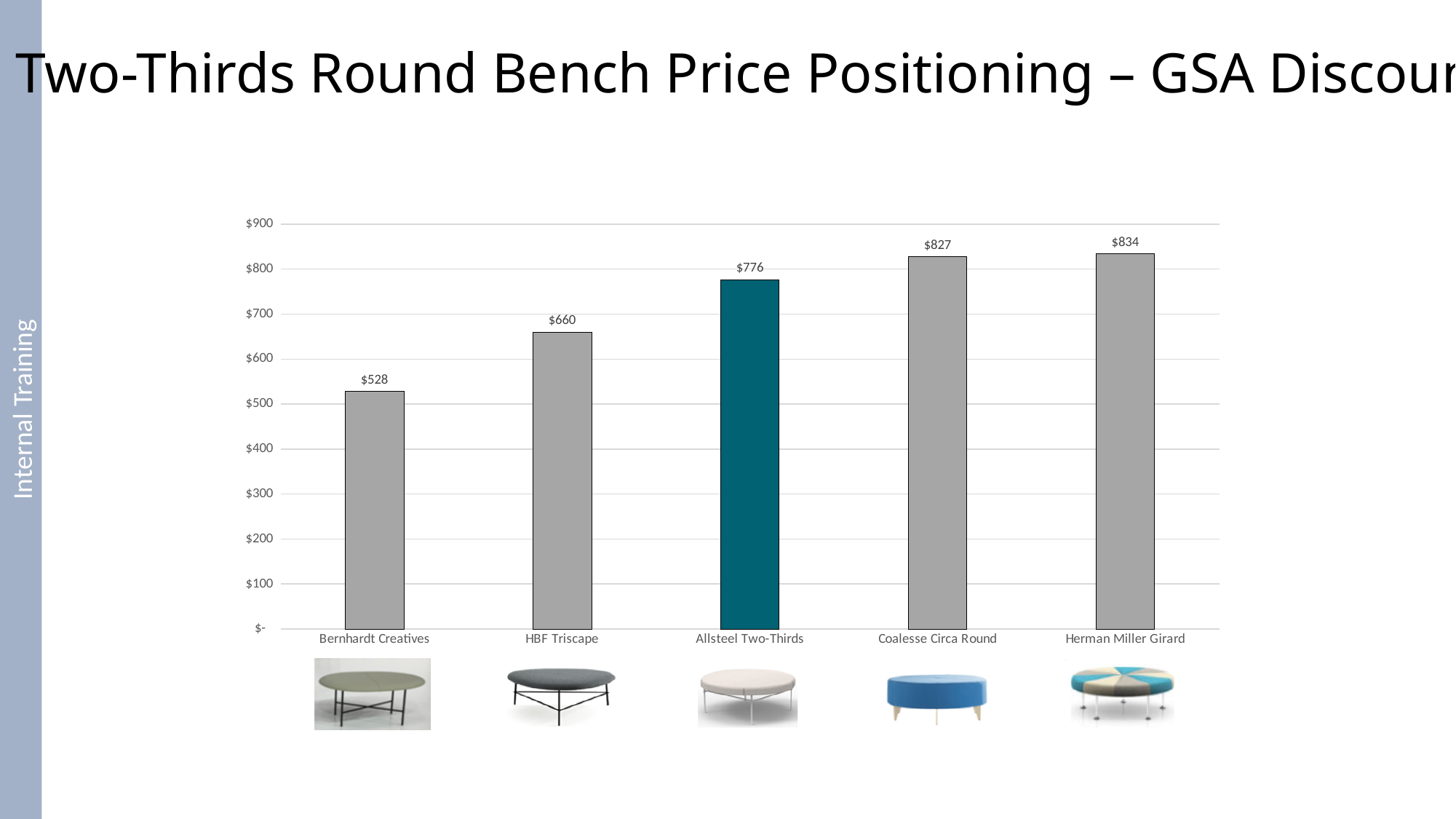
What is the value for Bernhardt Creatives? $528 Which category has the lowest value? Bernhardt Creatives Do the values rise or fall from left to right along the x axis? rise Which is larger, the value for HBF Triscape or the value for Allsteel Two-Thirds? Allsteel Two-Thirds What is the value for Coalesse Circa Round? $827 What is the difference between the values for Allsteel Two-Thirds and HBF Triscape? $116 What is the value for Allsteel Two-Thirds? $776 What kind of chart is shown on the slide? bar chart Which bar is coloured differently (teal) from the others? Allsteel Two-Thirds How many categories are shown on the x axis? 5 Is the value for HBF Triscape greater or less than $700? less What is the difference between the values for Herman Miller Girard and Bernhardt Creatives? $306